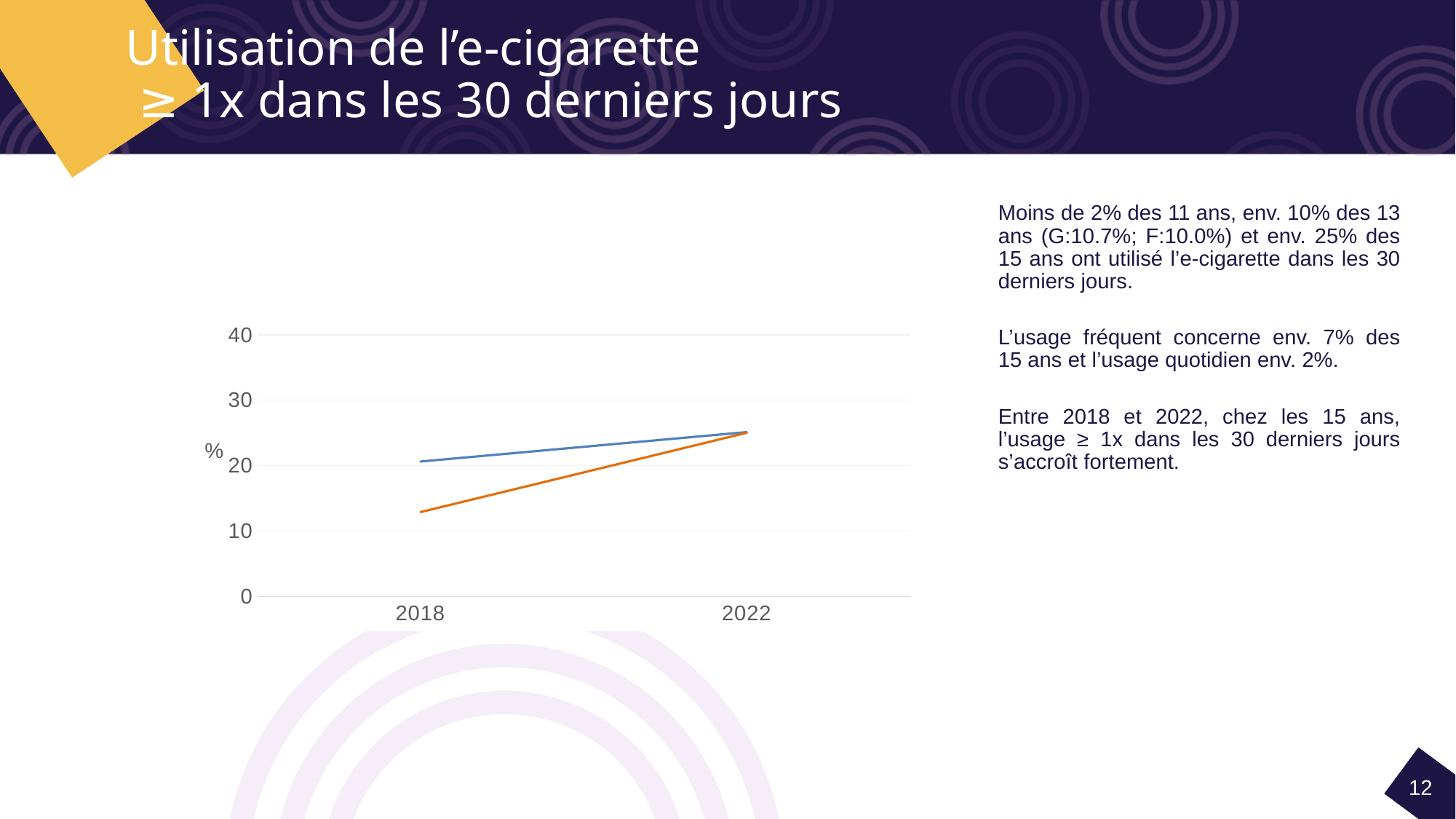
Is the value of the orange line in 2022 greater or less than 20? greater Is the value of the blue line in 2022 greater or less than 30? less What type of chart is shown on the slide? line chart Does the blue line rise or fall from 2018 to 2022? rise What is the label on the y axis of the chart? % Is the value of the orange line in 2018 greater or less than 20? less How many years are shown on the x axis of the chart? 2 Does the orange line rise or fall from 2018 to 2022? rise In 2018, which line has the higher value, the blue line or the orange line? the blue line Which years are shown on the x axis of the chart? 2018 and 2022 How many lines are plotted on the chart? 2